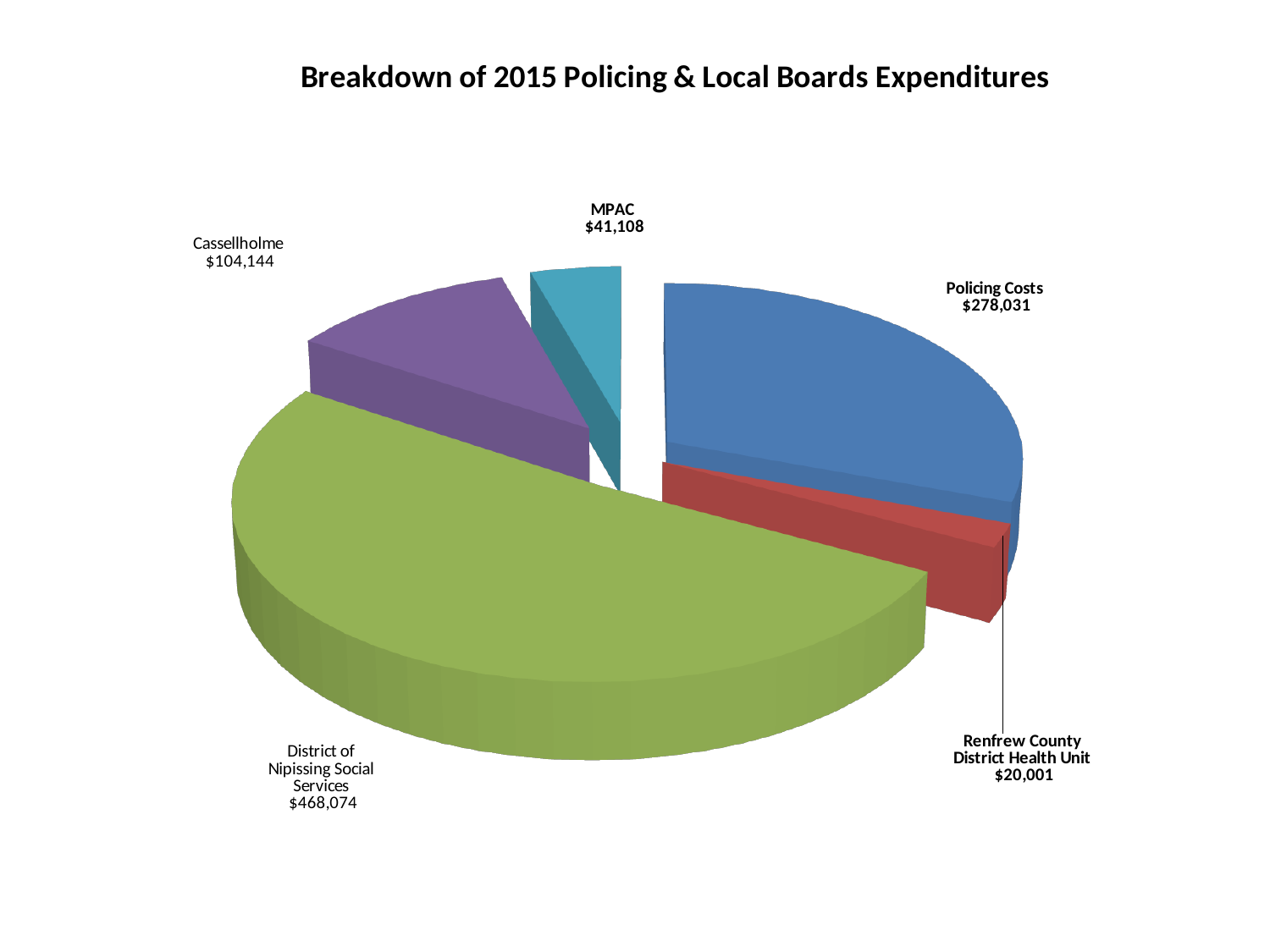
What is the title of the chart? Breakdown of 2015 Policing & Local Boards Expenditures What is the value for MPAC? $41,108 Which is larger, MPAC or Cassellholme? Cassellholme What is the value for District of Nipissing Social Services? $468,074 What is the difference between Policing Costs and Cassellholme? $173,887 What is the value for Cassellholme? $104,144 How many slices does the pie chart have? 5 What is the value for Policing Costs? $278,031 What is the value for Renfrew County District Health Unit? $20,001 What type of chart is shown on the slide? Pie chart Which category has the largest expenditure? District of Nipissing Social Services Which category has the smallest expenditure? Renfrew County District Health Unit